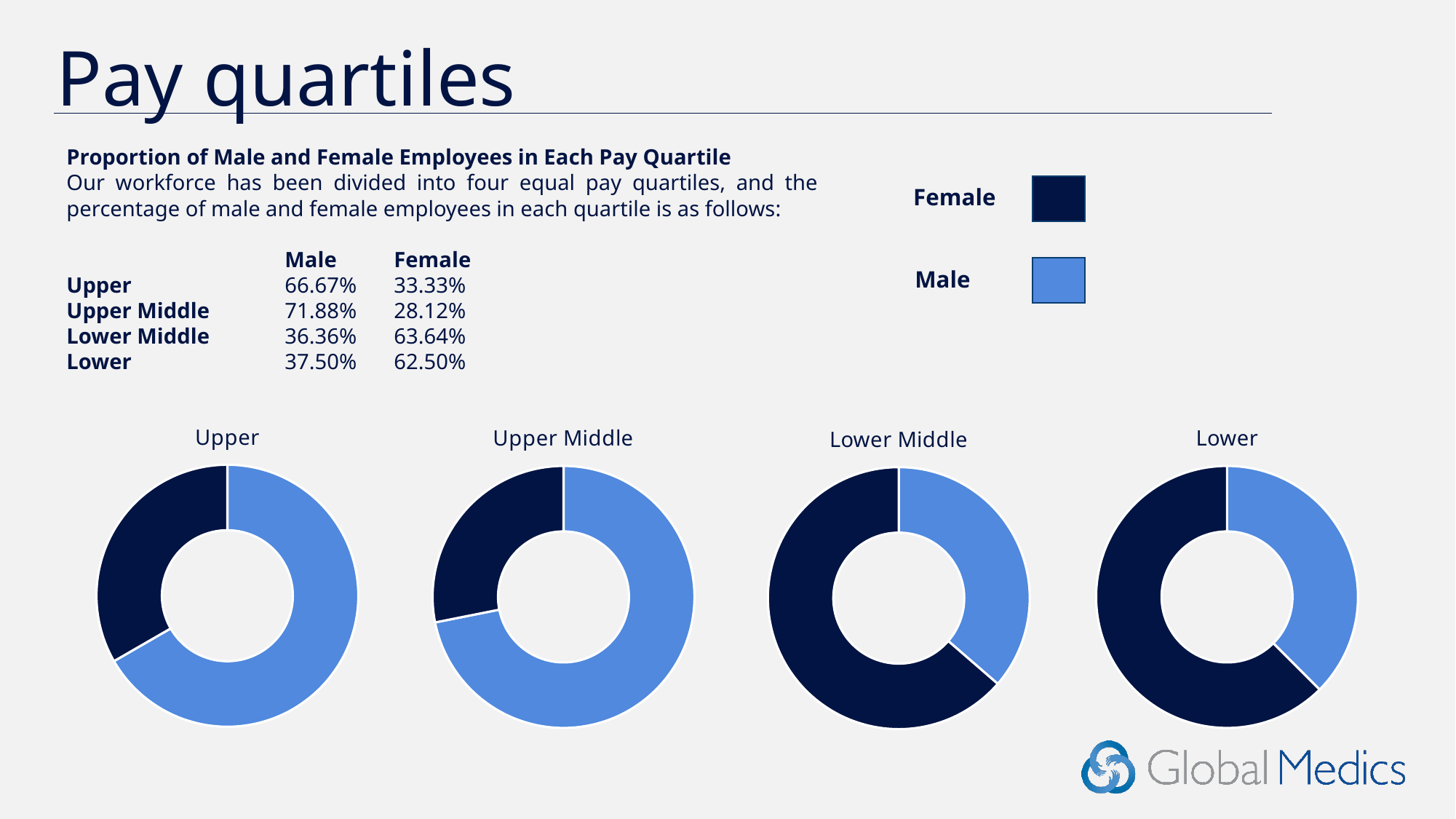
Which colour represents Female in the donut charts? Dark navy blue Which pay quartile chart has the largest male share? Upper Middle In the Upper Middle quartile chart, what is the percentage of female employees? 28.12% In the Lower Middle quartile chart, what is the percentage of female employees? 63.64% In the Upper quartile chart, which slice is larger, Male or Female? Male What kind of chart is used to show the pay quartiles on this slide? Donut (pie) chart How many donut charts are shown on the slide? 4 In the Upper quartile chart, what is the percentage of male employees? 66.67% Which pay quartile chart has the smallest female share? Upper Middle In the Lower quartile chart, what is the percentage of male employees? 37.50% In the Lower Middle quartile chart, what is the difference between the female and male percentages? 27.28% How many series does the legend list? 2